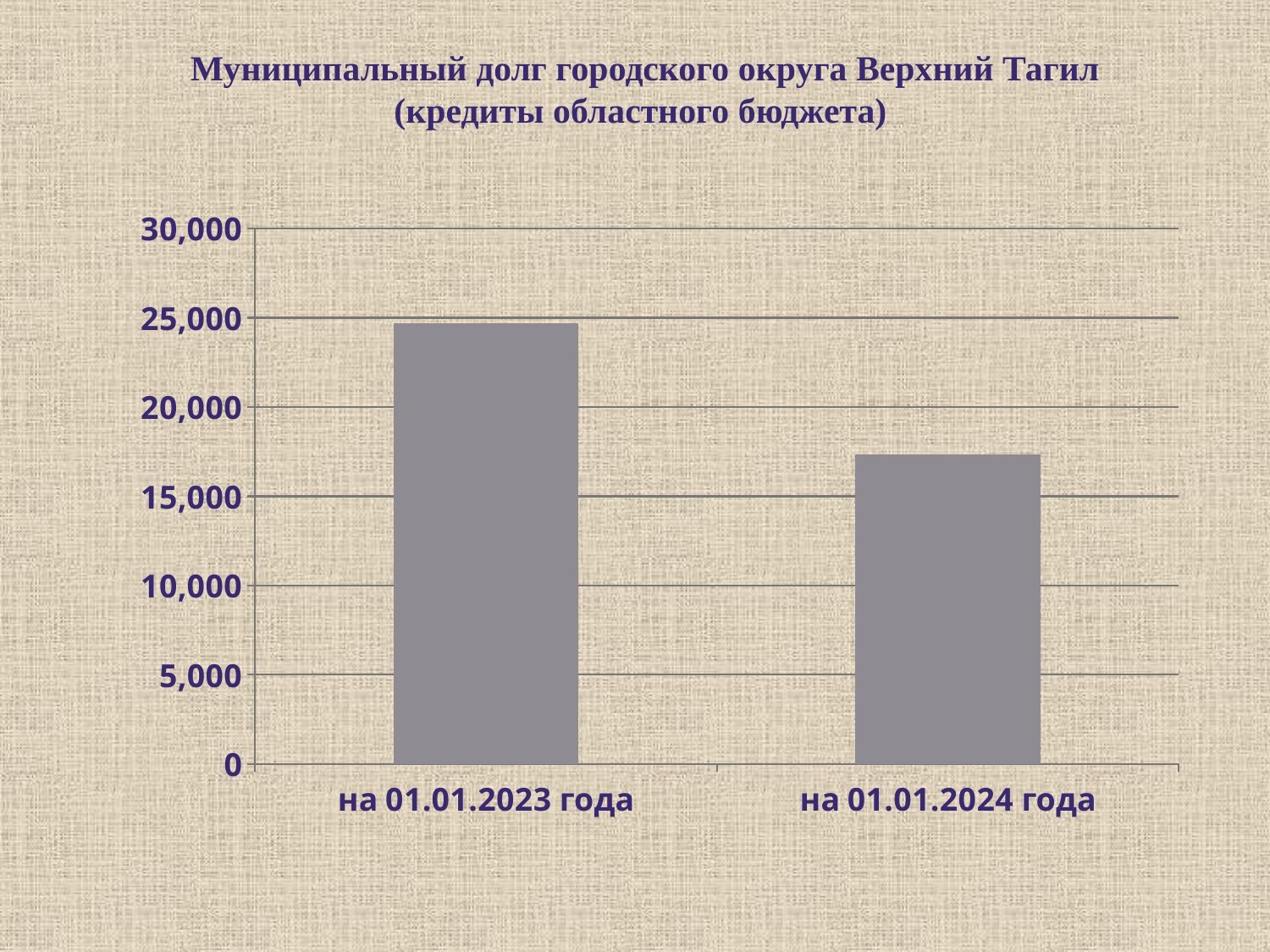
Which category has the highest value? на 01.01.2023 года What is the highest value shown on the y axis? 30,000 Do the values rise or fall from на 01.01.2023 года to на 01.01.2024 года? fall What is the title of the chart? Муниципальный долг городского округа Верхний Тагил (кредиты областного бюджета) Which is larger, the value for на 01.01.2023 года or the value for на 01.01.2024 года? на 01.01.2023 года Is the value for на 01.01.2023 года greater or less than 20,000? greater What kind of chart is shown on the slide? bar chart Which category has the lowest value? на 01.01.2024 года Is the value for на 01.01.2024 года greater or less than 20,000? less How many categories are shown on the x axis? 2 Is the value for на 01.01.2024 года greater or less than 15,000? greater